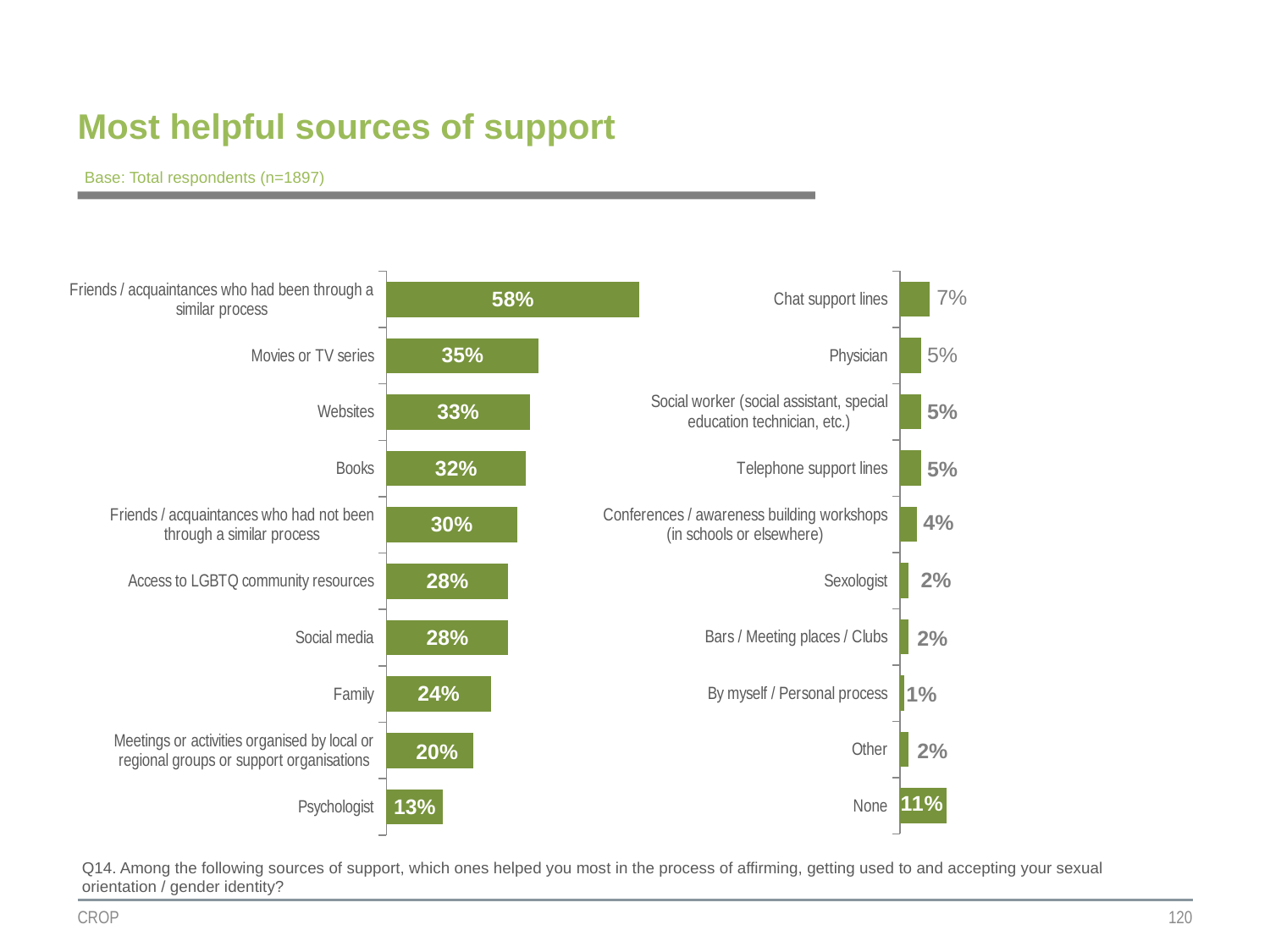
In the left chart, what is the difference between the values for Websites and Psychologist? 20% In the right chart, which category has the highest value? None In the right chart, which category has the lowest value? By myself / Personal process In the left chart, what is the value for Family? 24% How many categories are shown in the left chart? 10 In the left chart, which category has the highest value? Friends / acquaintances who had been through a similar process In the left chart, which category has the lowest value? Psychologist In the right chart, which is larger, the value for Conferences / awareness building workshops (in schools or elsewhere) or the value for Sexologist? Conferences / awareness building workshops (in schools or elsewhere) What type of chart is used on this slide? Bar chart In the left chart, what percentage is shown for Movies or TV series? 35% In the right chart, what percentage is shown for Chat support lines? 7% In the right chart, what is the value for None? 11%